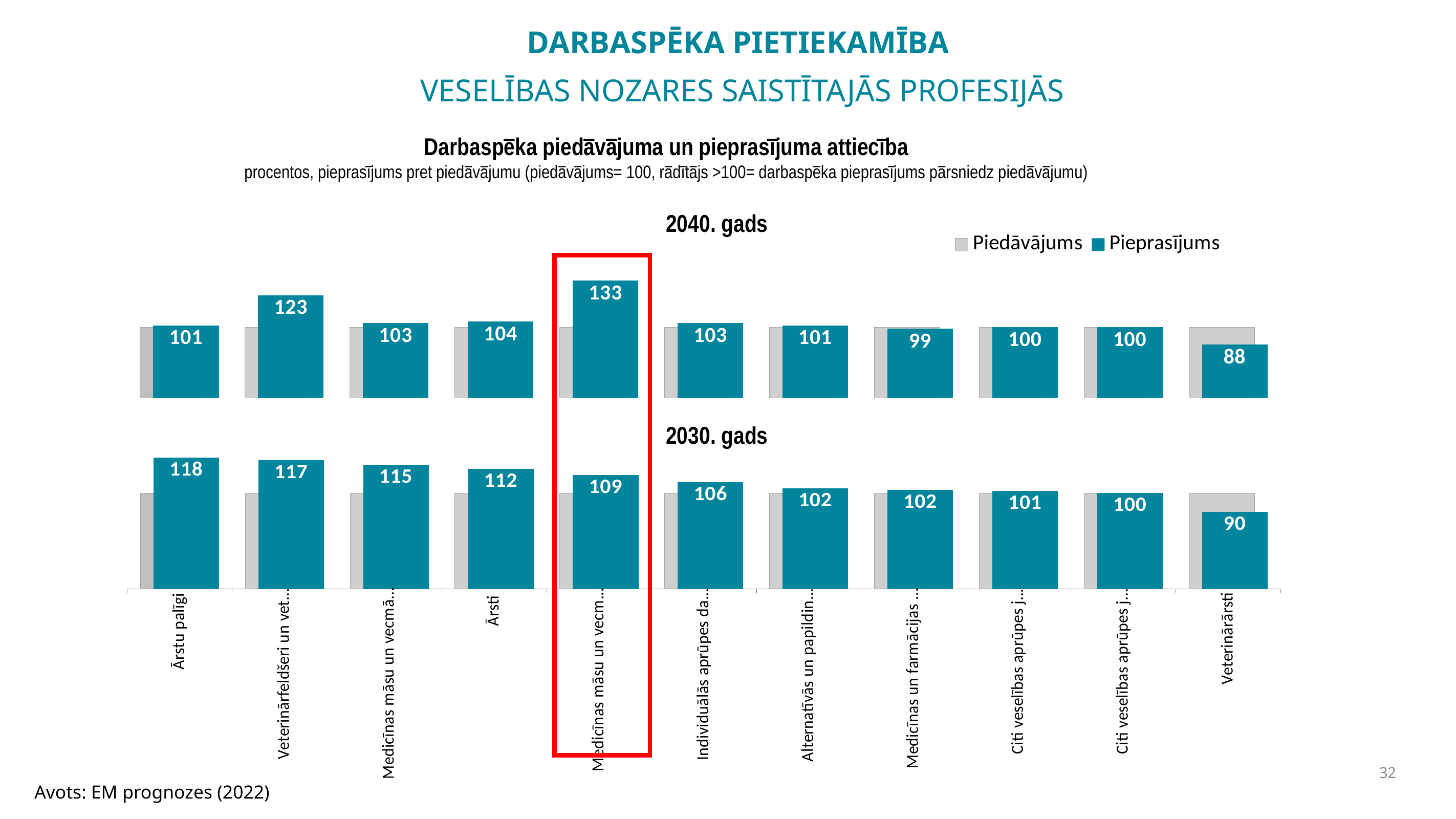
How many categories are shown along the x axis of the charts? 11 What kind of chart is used for the 2040. gads data? Bar chart In the 2040. gads chart, what is the Pieprasījums value for Veterinārārsti? 88 In the 2030. gads chart, which category has the highest Pieprasījums value? Ārstu palīgi In the 2040. gads chart, which has the larger Pieprasījums value, Ārsti or Ārstu palīgi? Ārsti In the 2040. gads chart, what is the Pieprasījums value for Ārsti? 104 In the 2030. gads chart, what is the Pieprasījums value for Veterinārārsti? 90 In the 2030. gads chart, which category has the lowest Pieprasījums value? Veterinārārsti In the 2030. gads chart, what is the Pieprasījums value for Ārstu palīgi? 118 In the 2040. gads chart, what is the highest Pieprasījums value shown? 133 How many series does the legend list? 2 In the 2030. gads chart, what is the difference between the Pieprasījums values for Ārstu palīgi and Ārsti? 6